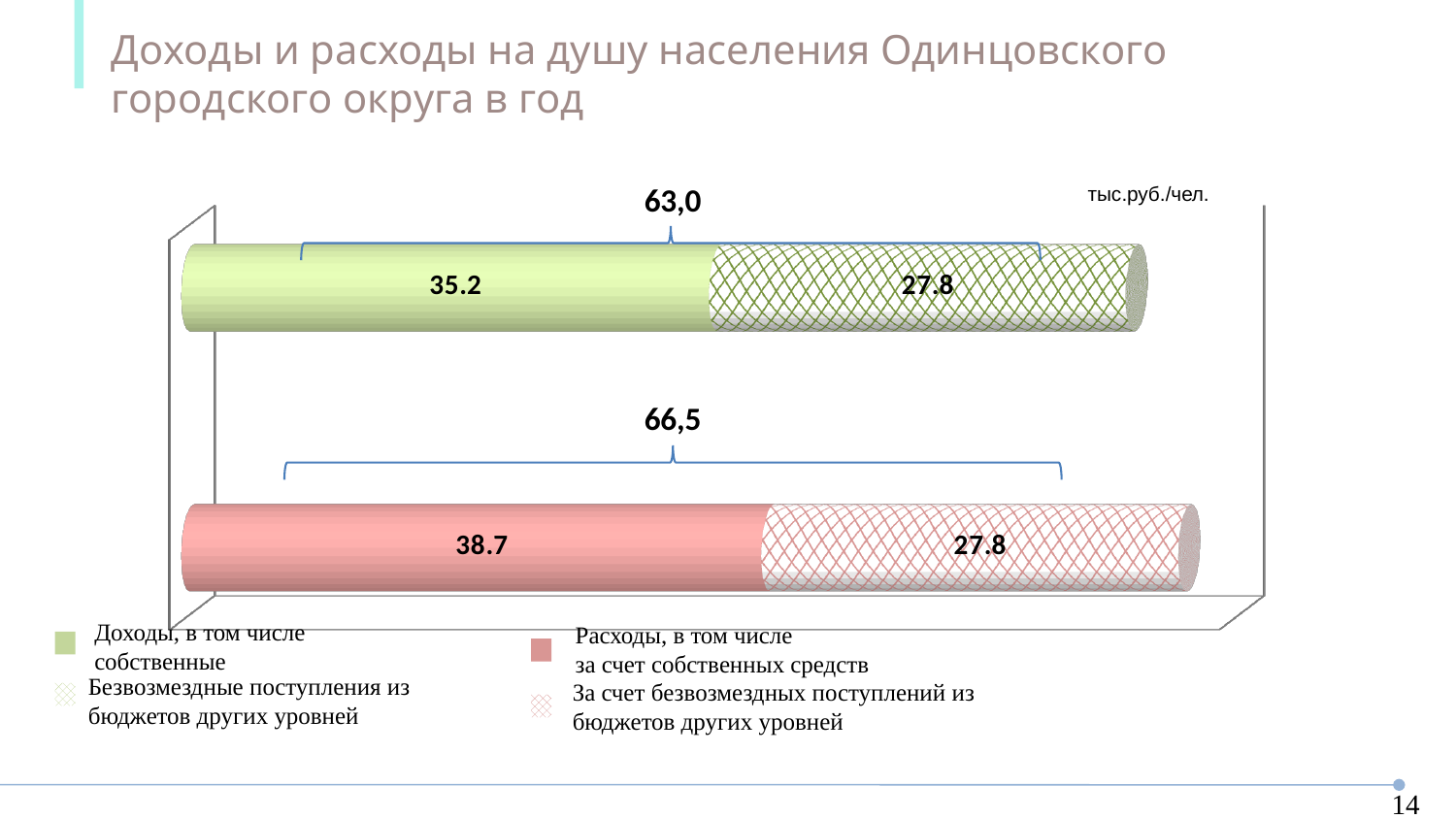
How many bars are shown in the chart? 2 What is the value of own income (Доходы, собственные) per capita? 35.2 What is the value of gratuitous receipts from other budgets (Безвозмездные поступления) in the income bar? 27.8 What type of chart is shown on the slide? Stacked bar chart What is the value of expenses from own funds (Расходы, за счет собственных средств)? 38.7 Which is larger: own income (35.2) or expenses from own funds (38.7)? Expenses from own funds (38.7) What is the total of the expenses (Расходы) bar? 66,5 What is the difference between expenses from own funds (38.7) and own income (35.2)? 3.5 What unit of measurement is indicated on the chart? тыс.руб./чел. What is the difference between total expenses (66,5) and total income (63,0)? 3,5 Which bar has the higher total: Доходы or Расходы? Расходы What is the total of the income (Доходы) bar? 63,0